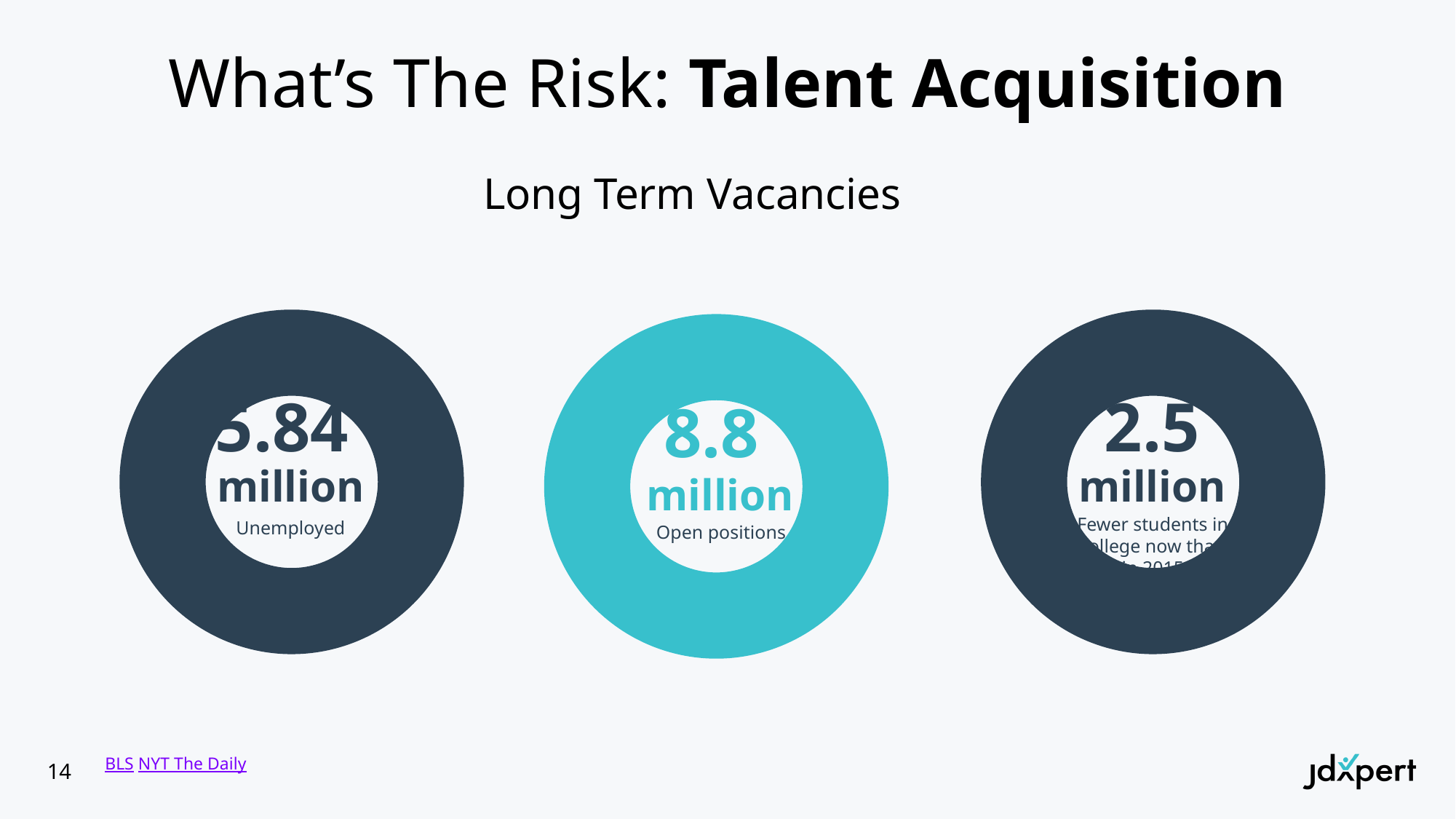
Which is larger, the number of open positions or the number unemployed? Open positions Which of the three figures is the smallest? Fewer students in college (2.5 million) How many circular figures are shown on the slide? 3 What value is shown in the right-hand circle for fewer students in college? 2.5 million What value is shown for Unemployed? 5.84 million What is the subtitle above the three circles? Long Term Vacancies Which of the three figures is the largest? Open positions (8.8 million) What value is shown for Open positions? 8.8 million Which circle is coloured teal rather than dark navy? The middle one (8.8 million Open positions) What is the difference between open positions and unemployed? 2.96 million